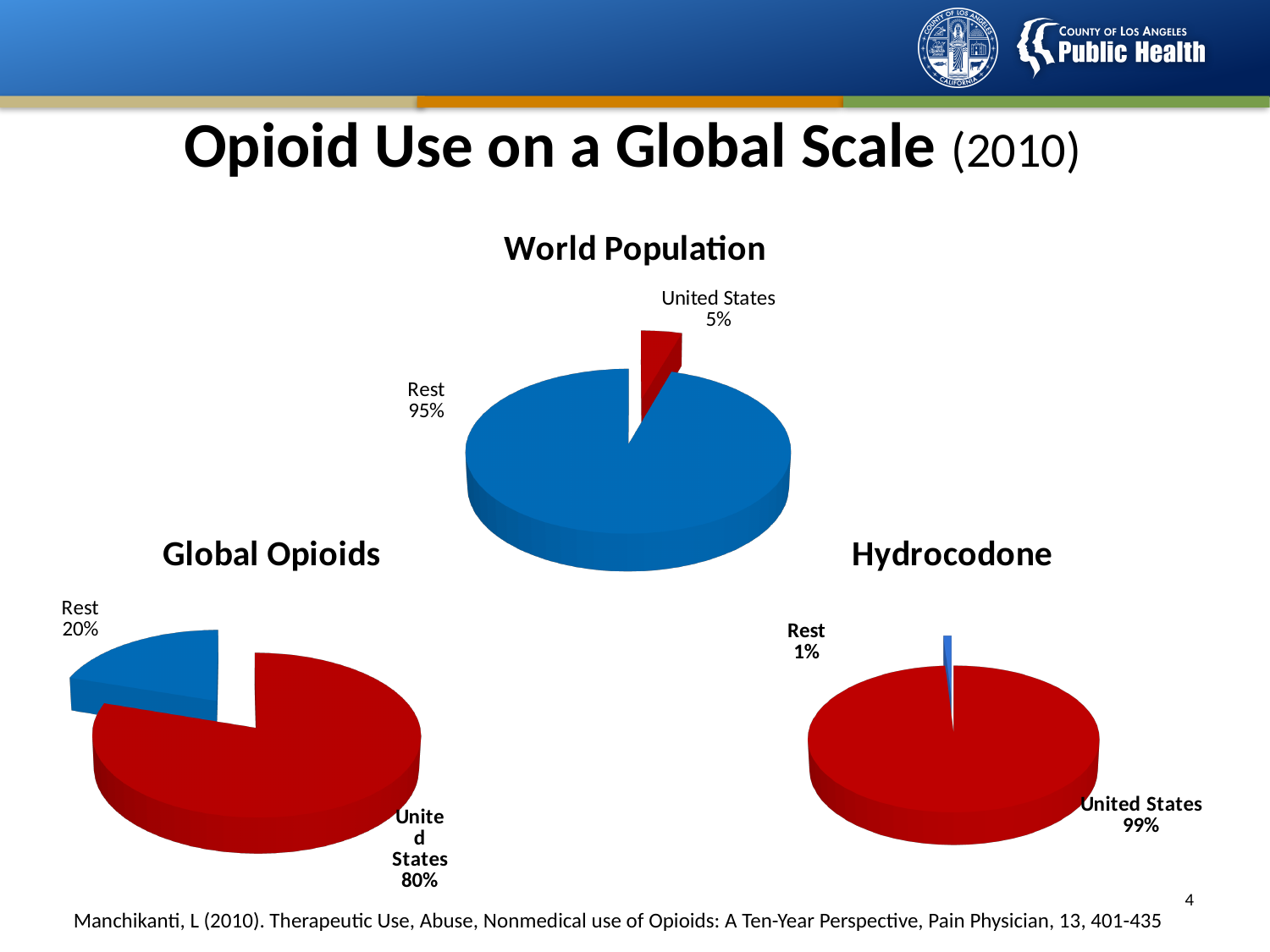
In the Global Opioids chart, which slice is the largest? United States In the World Population chart, what share does the United States slice represent? 5% In the World Population chart, which slice is the smallest? United States In the Hydrocodone chart, what is the difference between the United States share and the Rest share? 98% In the Global Opioids chart, which is larger, the United States slice or the Rest slice? United States In the Hydrocodone chart, what share does the United States slice represent? 99% In the Global Opioids chart, what share does the United States slice represent? 80% How many slices does the Hydrocodone chart have? 2 What kind of chart is the World Population chart? Pie chart